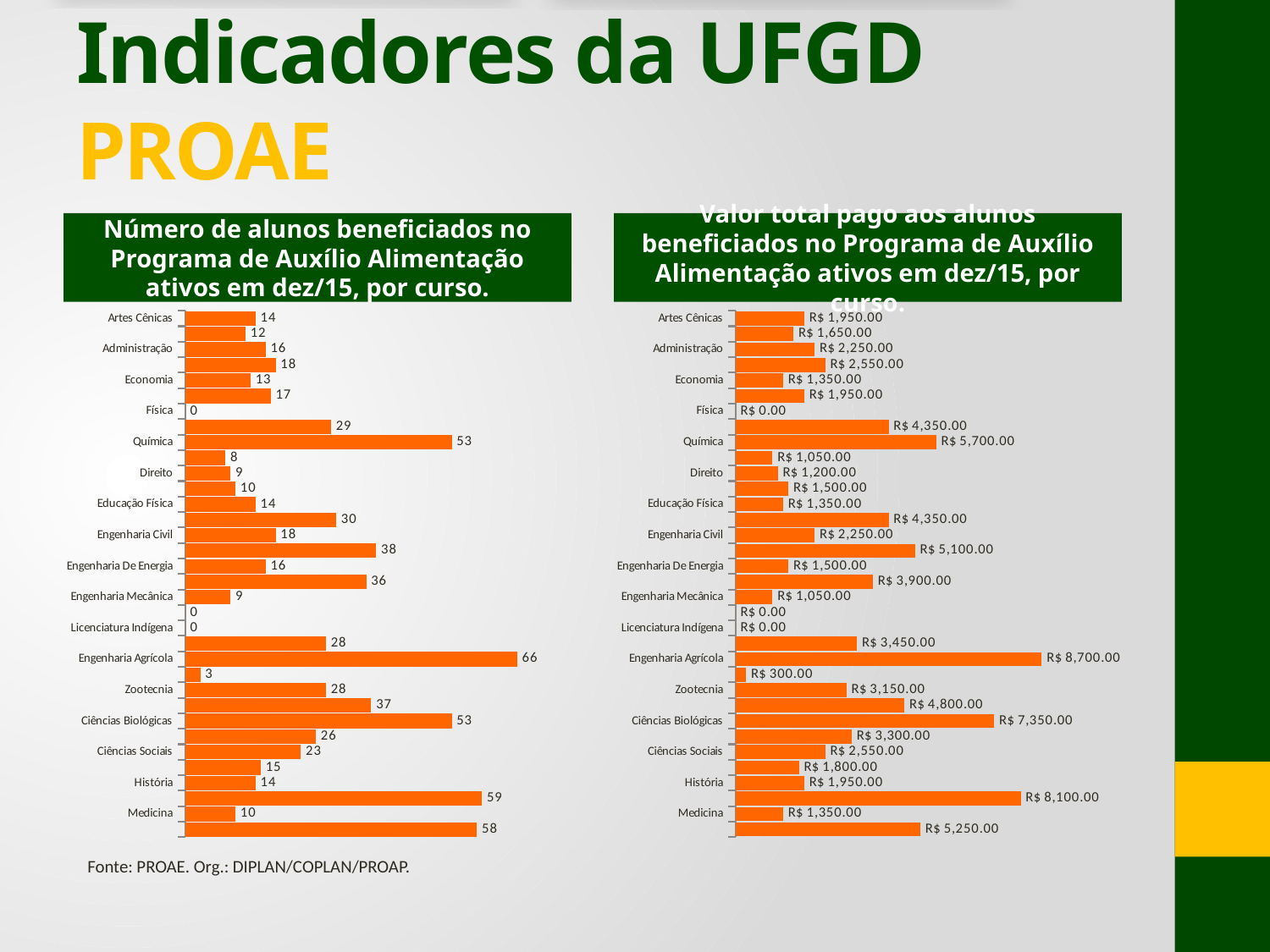
What kind of chart is the left chart, 'Número de alunos beneficiados no Programa de Auxílio Alimentação ativos em dez/15, por curso'? Bar chart In the right chart (Valor total pago aos alunos beneficiados), what is the value for Ciências Biológicas? R$ 7,350.00 What source is cited below the charts on the slide? PROAE. Org.: DIPLAN/COPLAN/PROAP. In the right chart (Valor total pago aos alunos beneficiados), which is larger, Química or Zootecnia? Química In the left chart (Número de alunos beneficiados), what is the value for Física? 0 In the left chart (Número de alunos beneficiados), what is the value for Química? 53 In the left chart (Número de alunos beneficiados), what is the difference between Ciências Biológicas and Ciências Sociais? 30 In the left chart (Número de alunos beneficiados), which is larger, Administração or Medicina? Administração In the left chart (Número de alunos beneficiados), what is the value for Engenharia Agrícola? 66 In the right chart (Valor total pago aos alunos beneficiados), what is the value for Engenharia Agrícola? R$ 8,700.00 In the left chart (Número de alunos beneficiados), which labeled course has the highest value? Engenharia Agrícola In the right chart (Valor total pago aos alunos beneficiados), what is the value for Direito? R$ 1,200.00